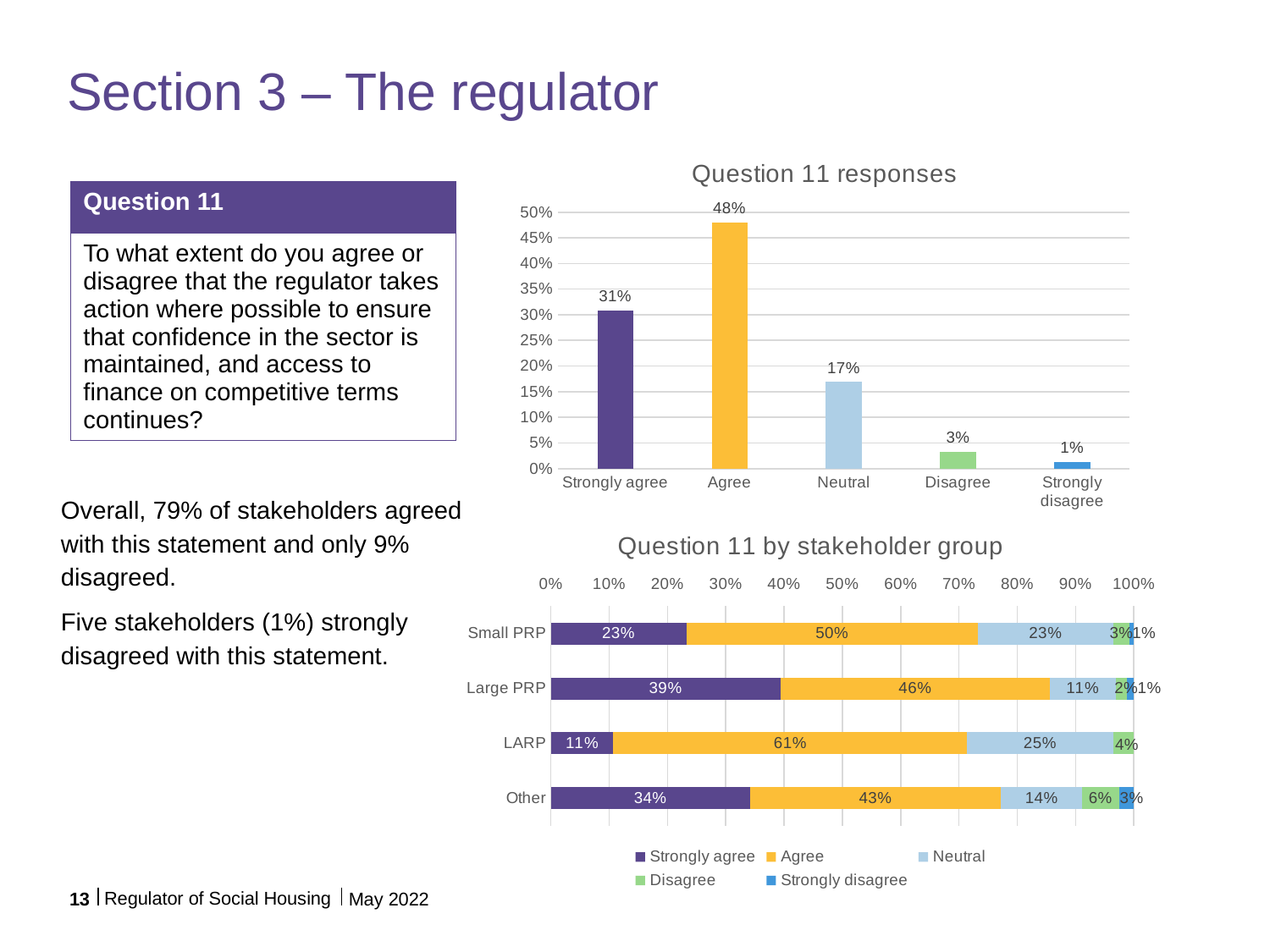
How many series does the legend of the 'Question 11 by stakeholder group' chart list? 5 What type of chart is the 'Question 11 responses' chart? Bar chart In the 'Question 11 by stakeholder group' chart, which stakeholder group has the highest Strongly agree percentage? Large PRP In the 'Question 11 by stakeholder group' chart, is the Neutral value for LARP larger or smaller than the Neutral value for Large PRP? Larger In the 'Question 11 responses' chart, how many response categories are shown on the x axis? 5 In the 'Question 11 responses' chart, which response category has the lowest value? Strongly disagree In the 'Question 11 responses' chart, what percentage of respondents chose Agree? 48% In the 'Question 11 responses' chart, what is the difference between the Strongly agree and Neutral values? 14% In the 'Question 11 by stakeholder group' chart, what is the total of the Other bar? 100% In the 'Question 11 by stakeholder group' chart, which colour represents the Agree series? Yellow In the 'Question 11 by stakeholder group' chart, what percentage of LARP respondents chose Agree? 61% In the 'Question 11 responses' chart, which response category has the highest value? Agree